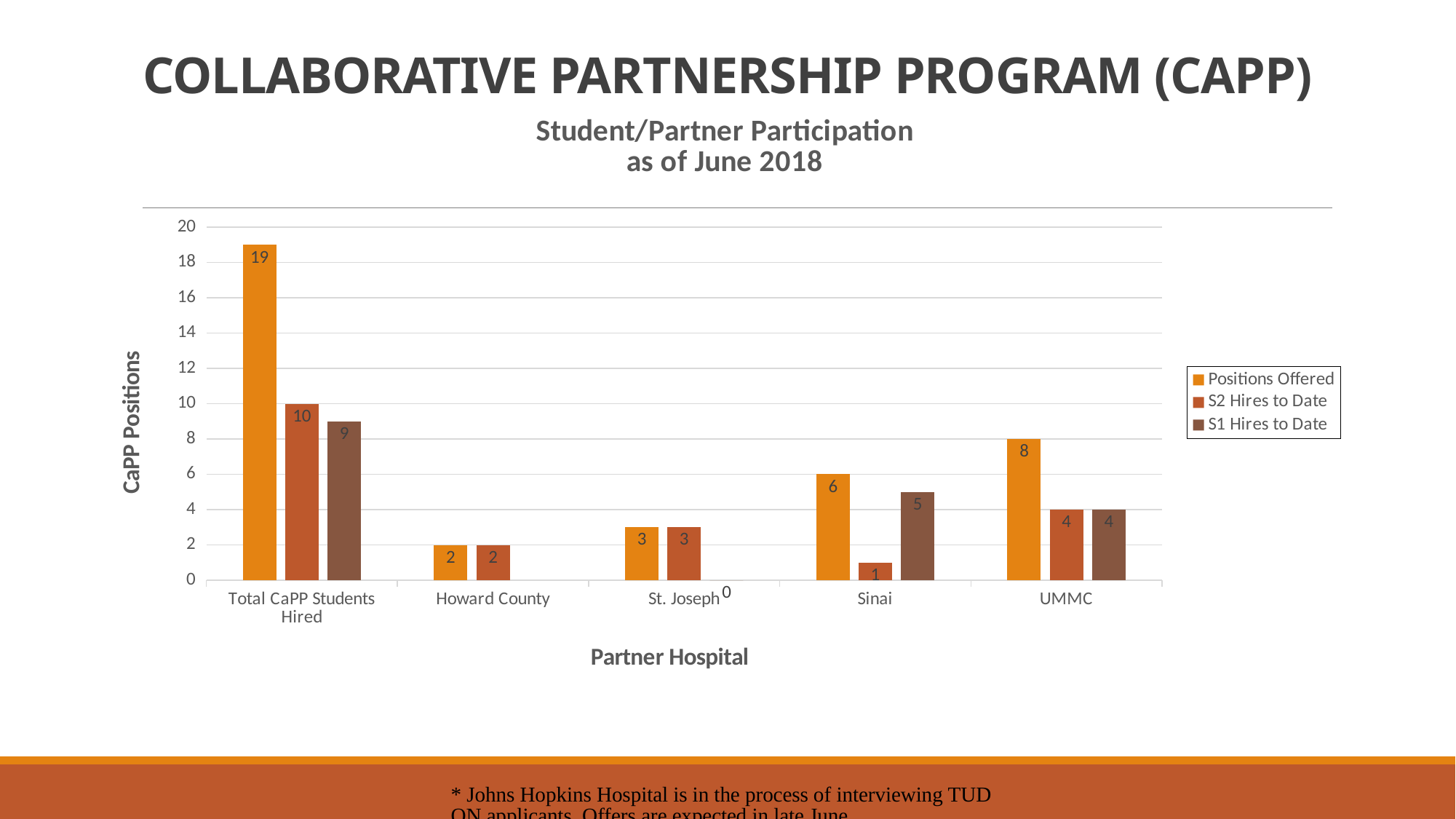
Which category has the lowest S2 Hires to Date value? Sinai What is the value of S1 Hires to Date for Total CaPP Students Hired? 9 How many series does the legend list? 3 How many categories are shown on the x axis? 5 Which partner hospital (excluding the Total CaPP Students Hired group) has the highest Positions Offered? UMMC What is the value of S1 Hires to Date for St. Joseph? 0 What is the difference between Positions Offered and S2 Hires to Date for Total CaPP Students Hired? 9 Which is larger for Sinai: S2 Hires to Date or S1 Hires to Date? S1 Hires to Date What is the value of S2 Hires to Date for UMMC? 4 What type of chart is shown on the slide? Bar chart Is the Positions Offered value for Total CaPP Students Hired greater or less than 18? greater What is the value of Positions Offered for Sinai? 6